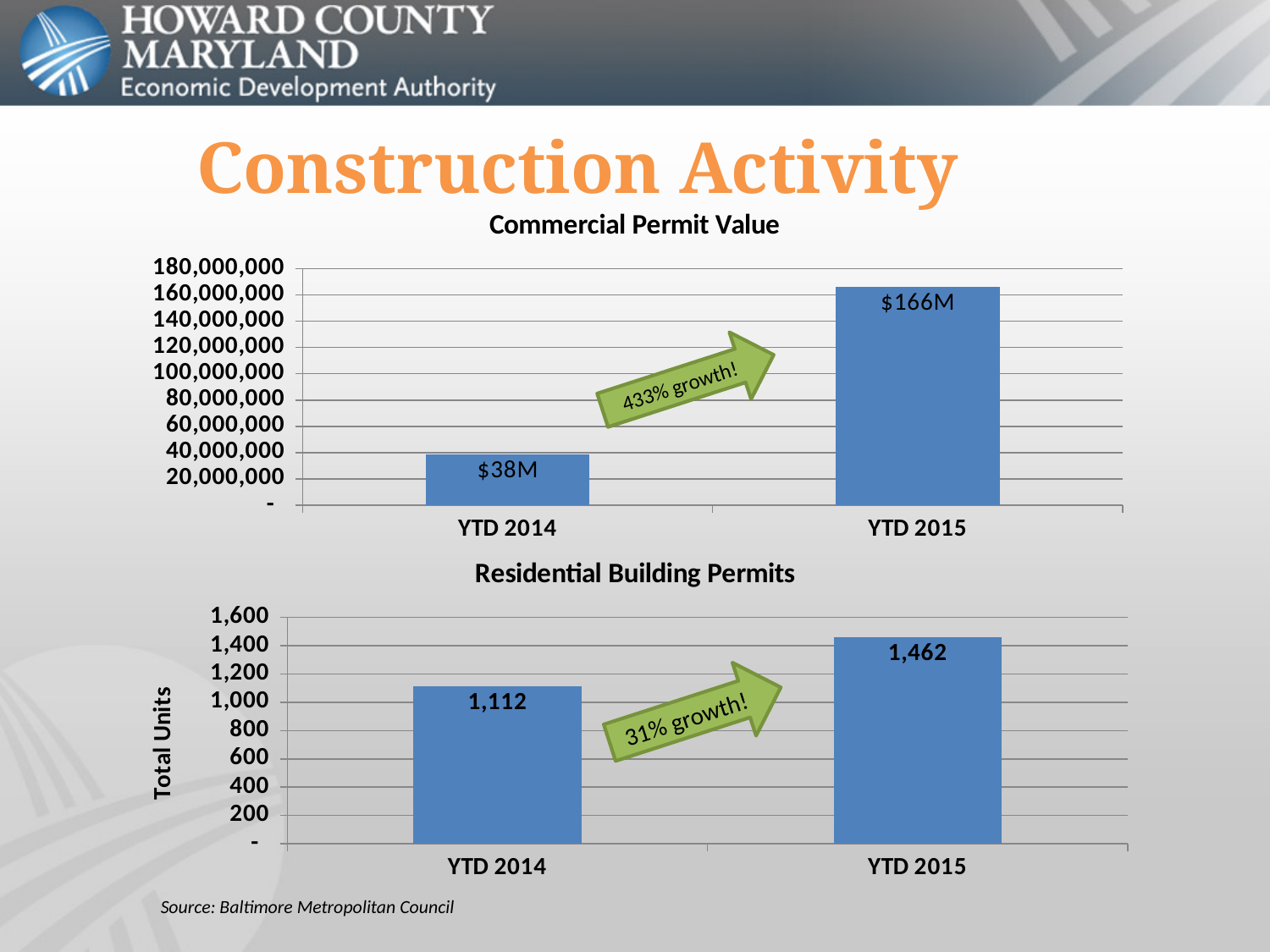
In the Residential Building Permits chart, which period has the higher number of units? YTD 2015 In the Commercial Permit Value chart, is the value for YTD 2014 greater or less than 40,000,000? less In the Commercial Permit Value chart, which period has the lower permit value? YTD 2014 In the Residential Building Permits chart, how many total units are shown for YTD 2014? 1,112 What kind of chart is the Commercial Permit Value chart? bar chart How many categories are shown on the x axis of the Residential Building Permits chart? 2 In the Residential Building Permits chart, how many total units are shown for YTD 2015? 1,462 In the Commercial Permit Value chart, what is the value for YTD 2015? $166M In the Residential Building Permits chart, is the value for YTD 2015 greater or less than 1,400? greater In the Commercial Permit Value chart, what is the value for YTD 2014? $38M What growth percentage is annotated on the Commercial Permit Value chart? 433% growth! In the Residential Building Permits chart, what is the difference in units between YTD 2015 and YTD 2014? 350